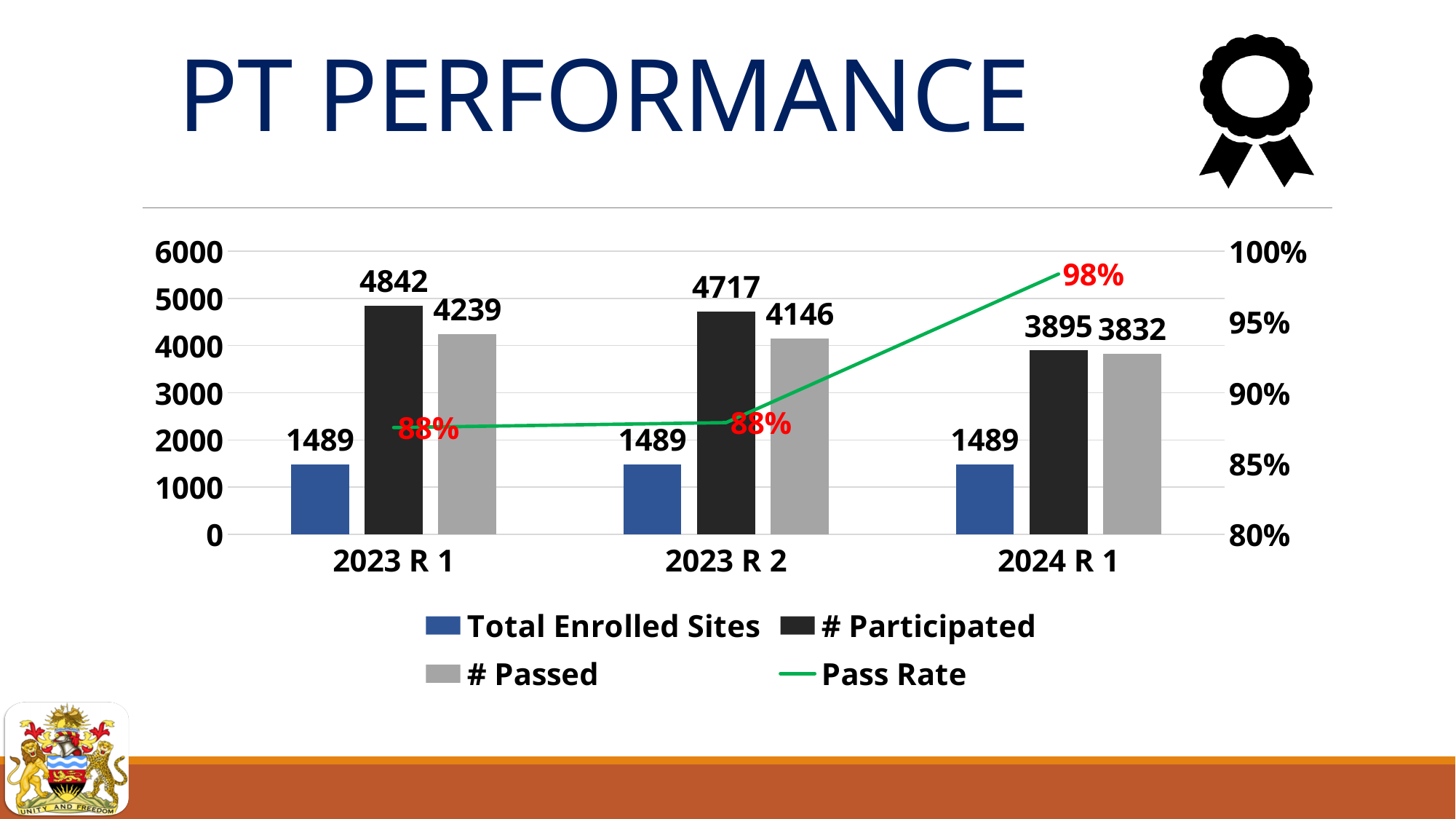
What is the Pass Rate for 2024 R 1? 98% How many periods are shown on the x axis? 3 What is the difference between # Participated and # Passed for 2023 R 2? 571 Which is larger: # Participated for 2023 R 2 or # Participated for 2024 R 1? 2023 R 2 What is the value of # Participated for 2023 R 1? 4842 Which series is shown as a green line? Pass Rate Which period has the highest # Participated value? 2023 R 1 What is the value of Total Enrolled Sites for 2023 R 2? 1489 Does the Pass Rate rise or fall from 2023 R 2 to 2024 R 1? rise What is the value of # Passed for 2024 R 1? 3832 How many series does the legend list? 4 Which period has the lowest # Passed value? 2024 R 1